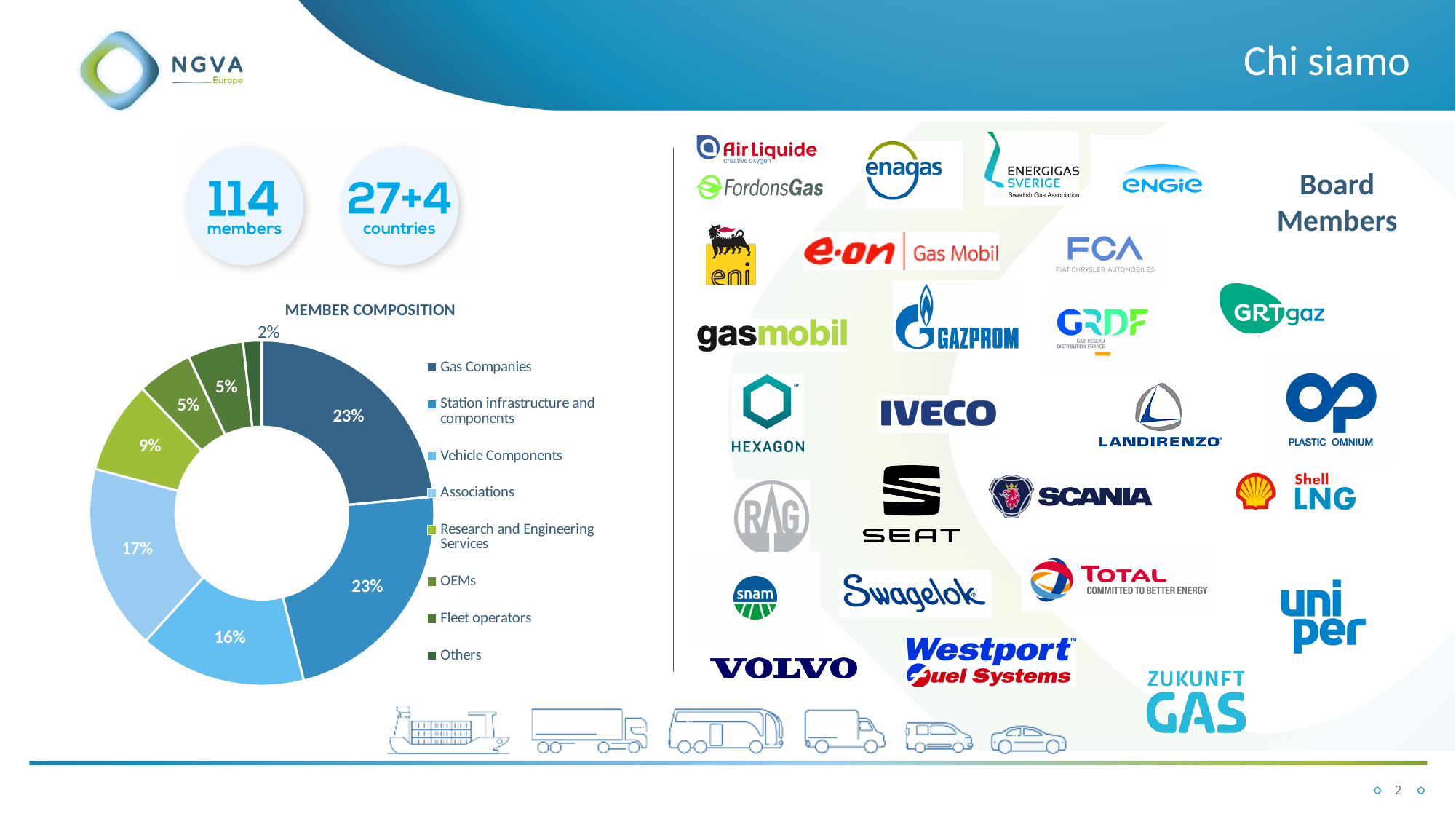
In the MEMBER COMPOSITION chart, what share do Associations represent? 17% Which category has the smallest share in the MEMBER COMPOSITION chart? Others In the MEMBER COMPOSITION chart, what is the combined share of Gas Companies and Station infrastructure and components? 46% In the MEMBER COMPOSITION chart, what share does Research and Engineering Services represent? 9% What kind of chart is the MEMBER COMPOSITION chart? pie chart (donut) How many categories does the MEMBER COMPOSITION chart show? 8 In the MEMBER COMPOSITION chart, what share does Others represent? 2% In the MEMBER COMPOSITION chart, what share do Vehicle Components represent? 16% In the MEMBER COMPOSITION chart, what is the difference between the share of Associations and the share of OEMs? 12% In the MEMBER COMPOSITION chart, which has the larger share: Research and Engineering Services or Fleet operators? Research and Engineering Services In the MEMBER COMPOSITION chart, what share do Gas Companies represent? 23% What is the title of the chart on the left of the slide? MEMBER COMPOSITION